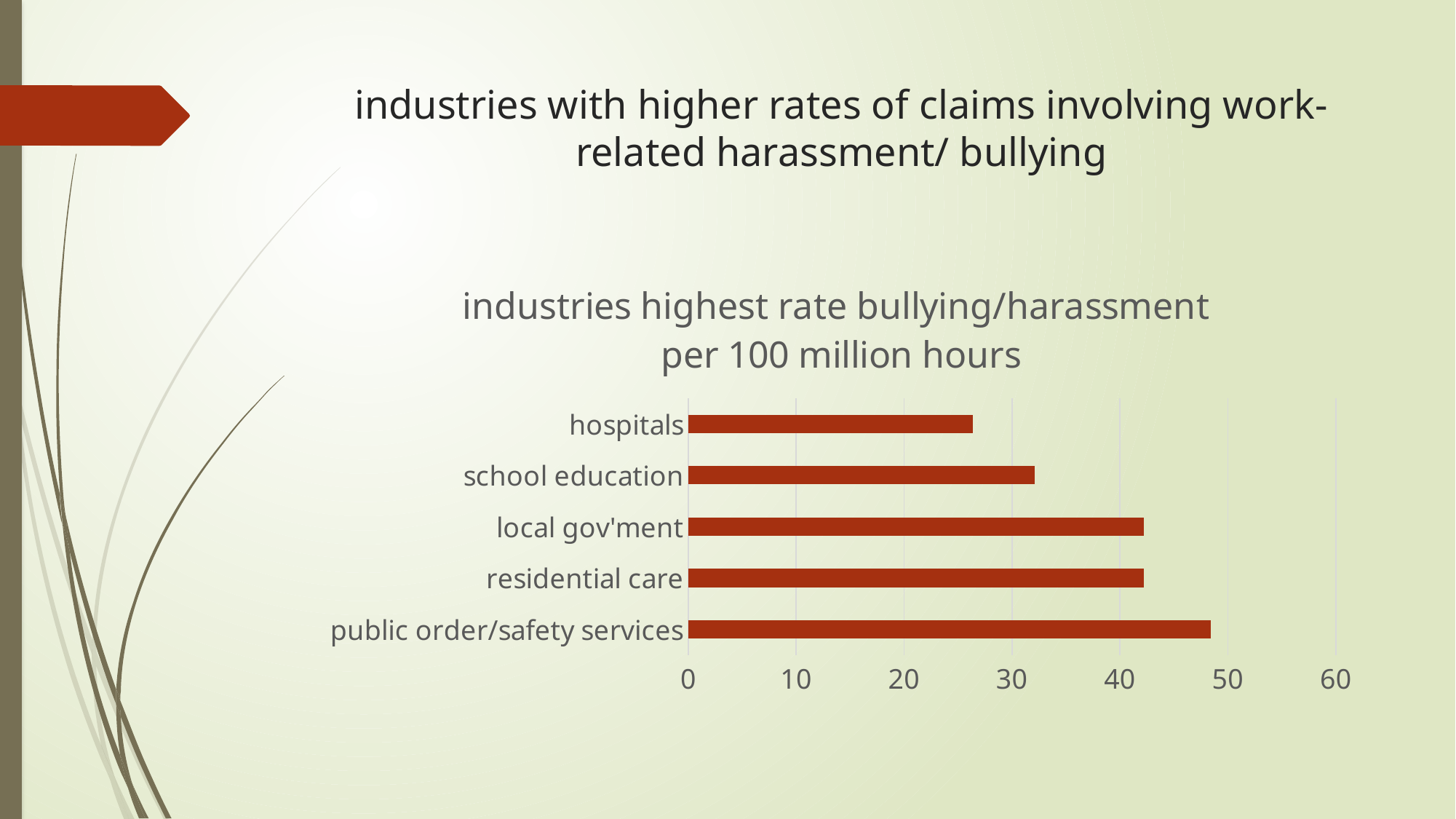
Which industry has the highest rate of bullying/harassment per 100 million hours? public order/safety services What is the title of the chart? industries highest rate bullying/harassment per 100 million hours How many industries are plotted in the chart? 5 Which industry has the lowest rate of bullying/harassment per 100 million hours? hospitals Is the value for hospitals greater or less than 30? less Is the value for public order/safety services greater or less than 50? less What kind of chart is shown on the slide? bar chart Which has a higher rate, hospitals or school education? school education Which has a higher rate, residential care or hospitals? residential care Is the value for school education greater or less than 30? greater